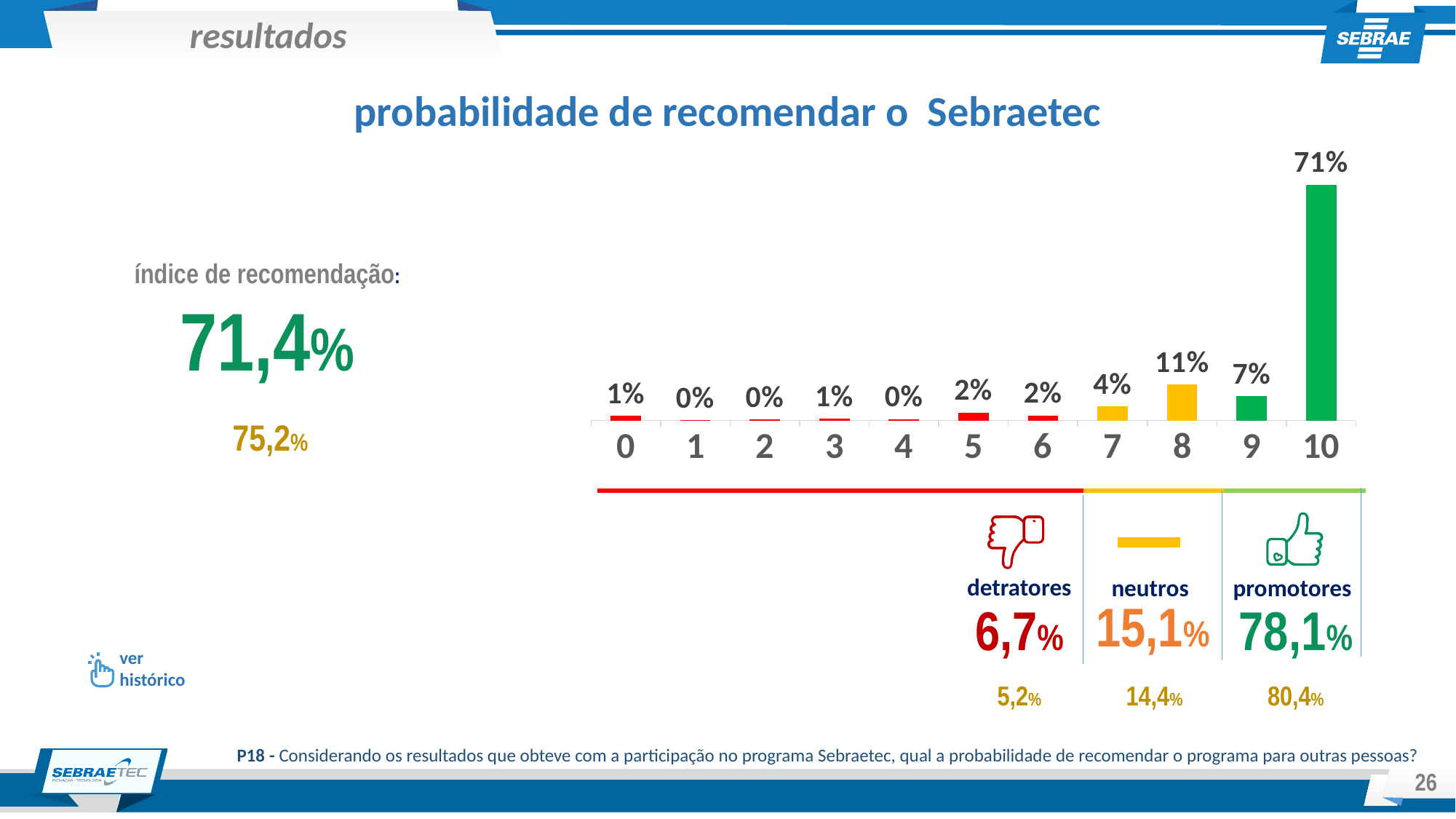
What is the value for category 8 in the chart? 11% Which is larger, the value for category 8 or the value for category 9? 8 How many categories are shown on the x axis of the chart? 11 What is the value for category 10 in the chart? 71% What kind of chart is shown on the slide? bar chart Which category has the highest value in the chart? 10 What is the difference between the values for categories 8 and 9? 4% What is the difference between the values for categories 10 and 8? 60% What colour are the bars for categories 9 and 10 in the chart? green What is the value for category 7 in the chart? 4% What is the value for category 9 in the chart? 7% Which is larger, the value for category 7 or the value for category 5? 7